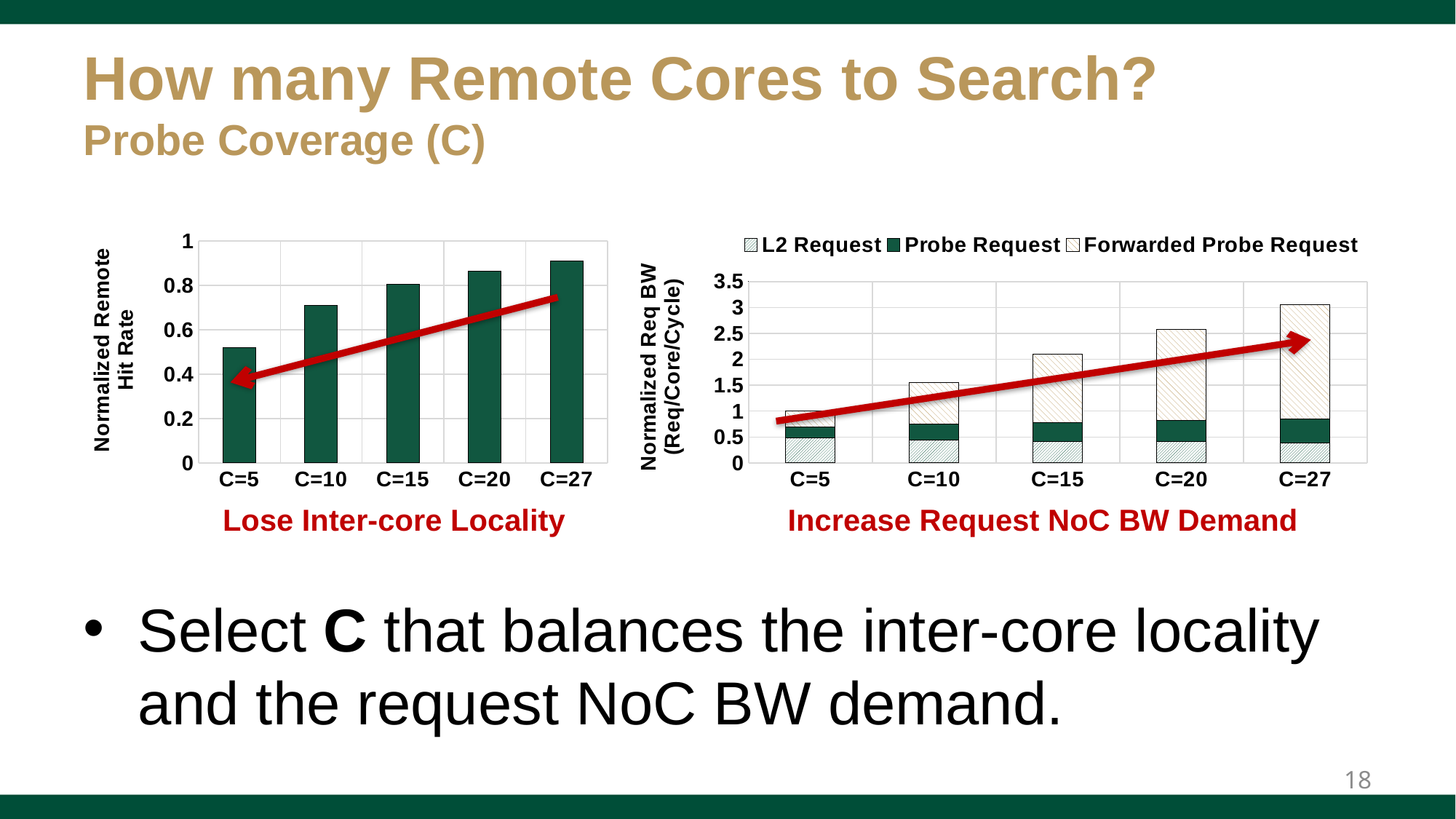
In the right chart (Normalized Req BW), which stacked bar is taller, C=10 or C=20? C=20 In the left chart (Normalized Remote Hit Rate), is the value for C=15 greater or less than 0.6? greater In the right chart (Normalized Req BW), is the total stacked bar for C=27 greater or less than 2.5? greater In the left chart (Normalized Remote Hit Rate), which category has the lowest value? C=5 In the right chart (Normalized Req BW), what is the name of the series shown in solid dark green? Probe Request In the right chart (Normalized Req BW), which category has the tallest stacked bar? C=27 In the left chart (Normalized Remote Hit Rate), how many categories are plotted on the x axis? 5 In the left chart (Normalized Remote Hit Rate), is the value for C=5 greater or less than 0.6? less In the left chart (Normalized Remote Hit Rate), which category has the highest value? C=27 In the left chart (Normalized Remote Hit Rate), do the values rise or fall as C increases along the x axis? rise In the right chart (Normalized Req BW), how many series does the legend list? 3 In the left chart (Normalized Remote Hit Rate), what kind of chart is shown? bar chart